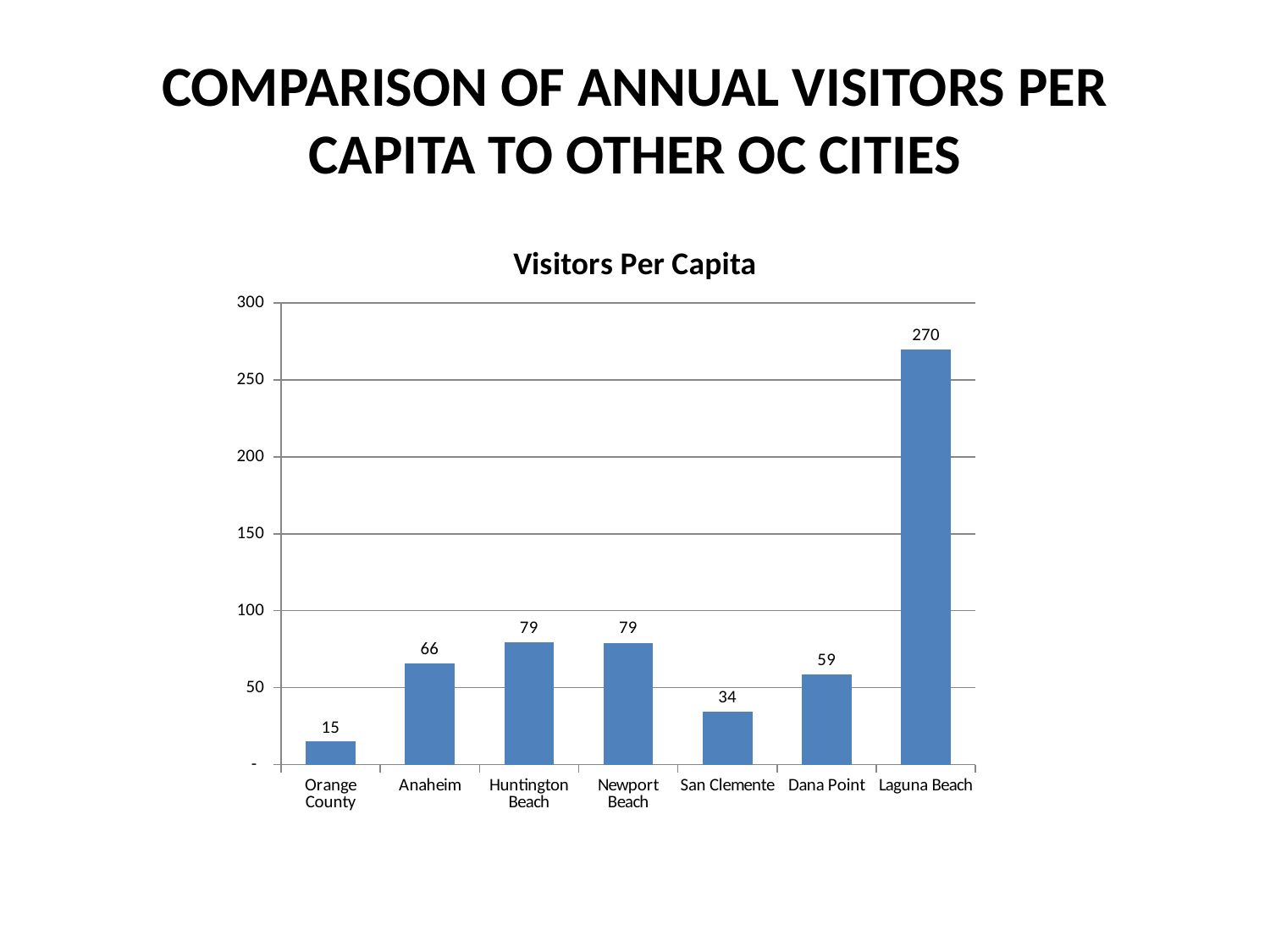
Is the value for Laguna Beach greater or less than 250? greater What is the visitors per capita value for Laguna Beach? 270 How many categories are shown on the x axis of the chart? 7 Which category has the lowest visitors per capita? Orange County What kind of chart is shown on the slide? Bar chart Which has a higher visitors per capita value, Anaheim or Dana Point? Anaheim Which category has the highest visitors per capita? Laguna Beach What is the visitors per capita value for San Clemente? 34 What is the visitors per capita value for Orange County? 15 What is the visitors per capita value for Dana Point? 59 What is the difference in visitors per capita between Laguna Beach and Anaheim? 204 What is the difference in visitors per capita between Dana Point and San Clemente? 25